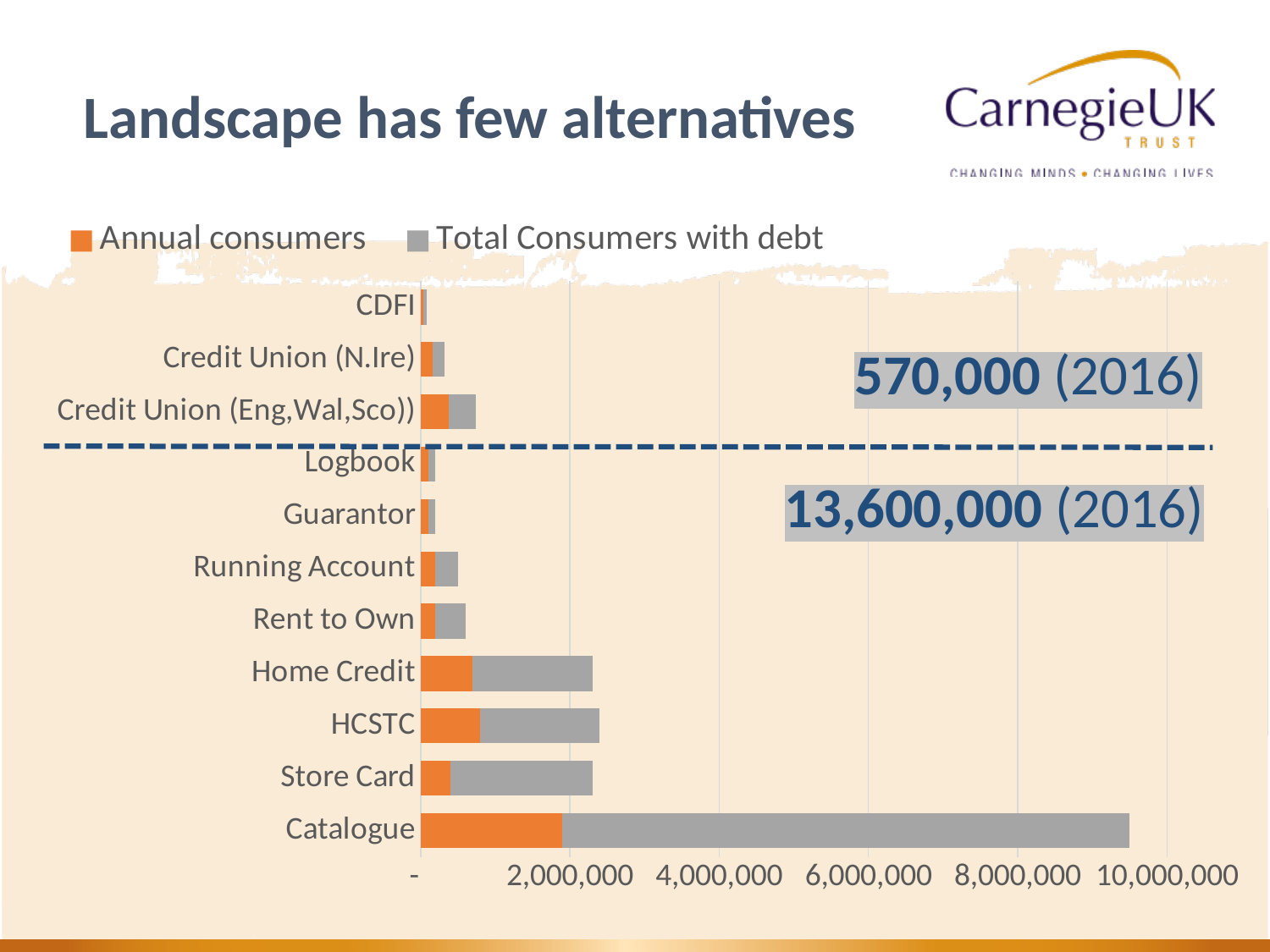
Which has the longer total bar, Credit Union (Eng,Wal,Sco)) or Credit Union (N.Ire)? Credit Union (Eng,Wal,Sco)) How many series does the chart's legend list? 2 What kind of chart is shown on the slide? bar chart Which category has the largest Annual consumers segment? Catalogue Is the total bar for Catalogue greater or less than 10,000,000? less Is the total bar for Catalogue greater or less than 8,000,000? greater Is the total bar for Home Credit greater or less than 4,000,000? less Which category has the shortest total bar on the chart? CDFI What are the two series named in the chart's legend? Annual consumers; Total Consumers with debt Which has the longer total bar, Catalogue or HCSTC? Catalogue How many categories are plotted on the chart? 11 Which category has the longest total bar on the chart? Catalogue